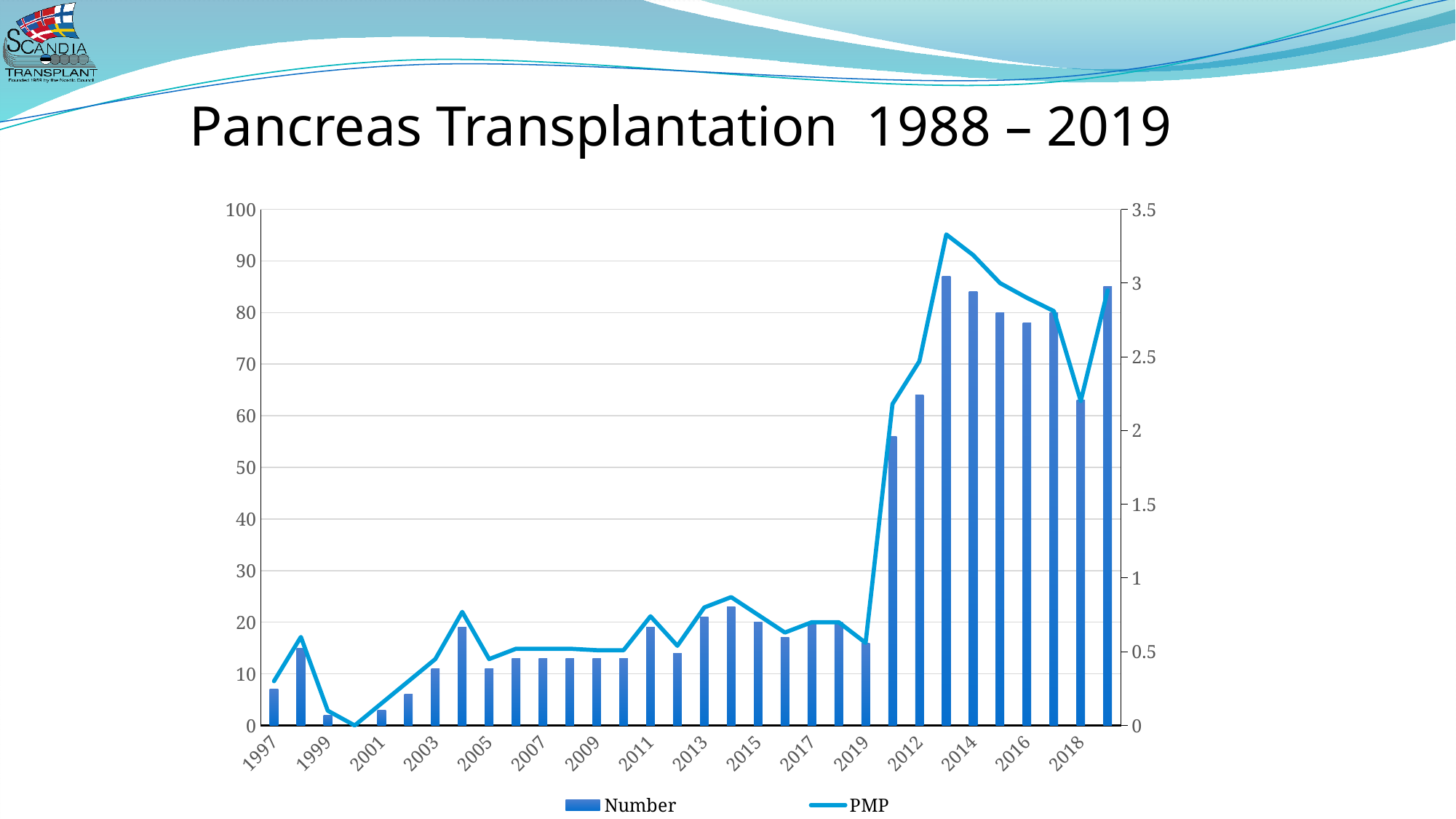
What is the title of the slide's chart? Pancreas Transplantation 1988 – 2019 Which has the larger Number bar, 2012 or 2019? 2012 Is the Number bar for 1997 greater or less than 10? less How many series does the legend list? 2 Which has the larger Number bar, 2014 or 2018? 2014 Is the Number bar for 2014 greater or less than 70? greater Is the PMP value for 2014 greater or less than 3 on the right axis? greater What are the two series named in the legend? Number and PMP What kind of chart is shown on the slide? A bar chart combined with a line